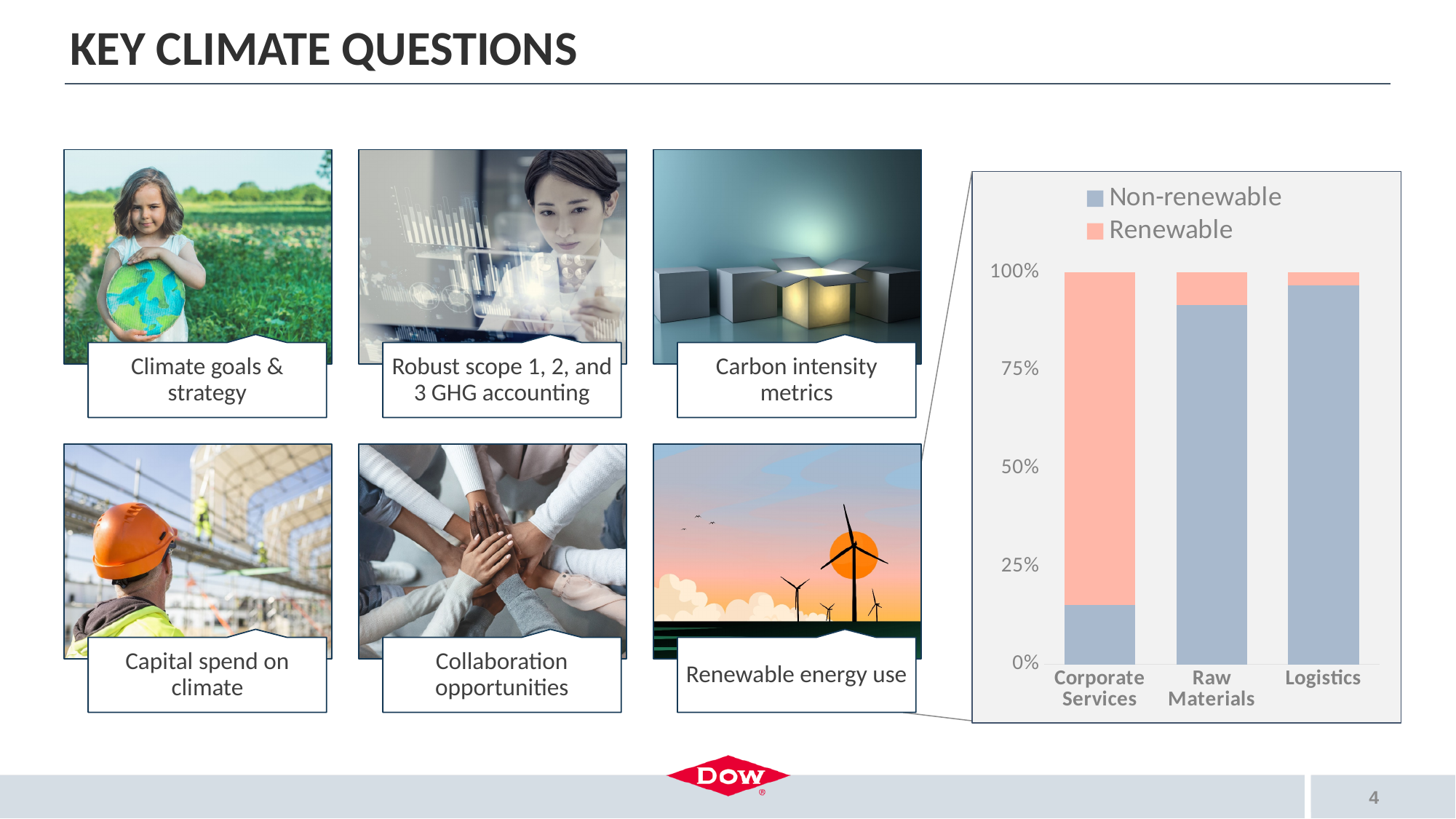
Which category has the largest Renewable share? Corporate Services Which is larger: the Renewable share for Corporate Services or the Renewable share for Raw Materials? Corporate Services Is the Renewable share for Logistics greater or less than 25%? less Is the Non-renewable share for Corporate Services greater or less than 25%? less How many categories are shown on the x axis of the chart? 3 Which category has the smallest Non-renewable share? Corporate Services How many series does the chart's legend list? 2 What is the total height of each stacked bar in the chart? 100% What kind of chart is shown on the slide? Stacked bar chart Which colour represents the Renewable series in the chart? Orange (salmon) Which category has the largest Non-renewable share? Logistics Is the Non-renewable share for Raw Materials greater or less than 75%? greater